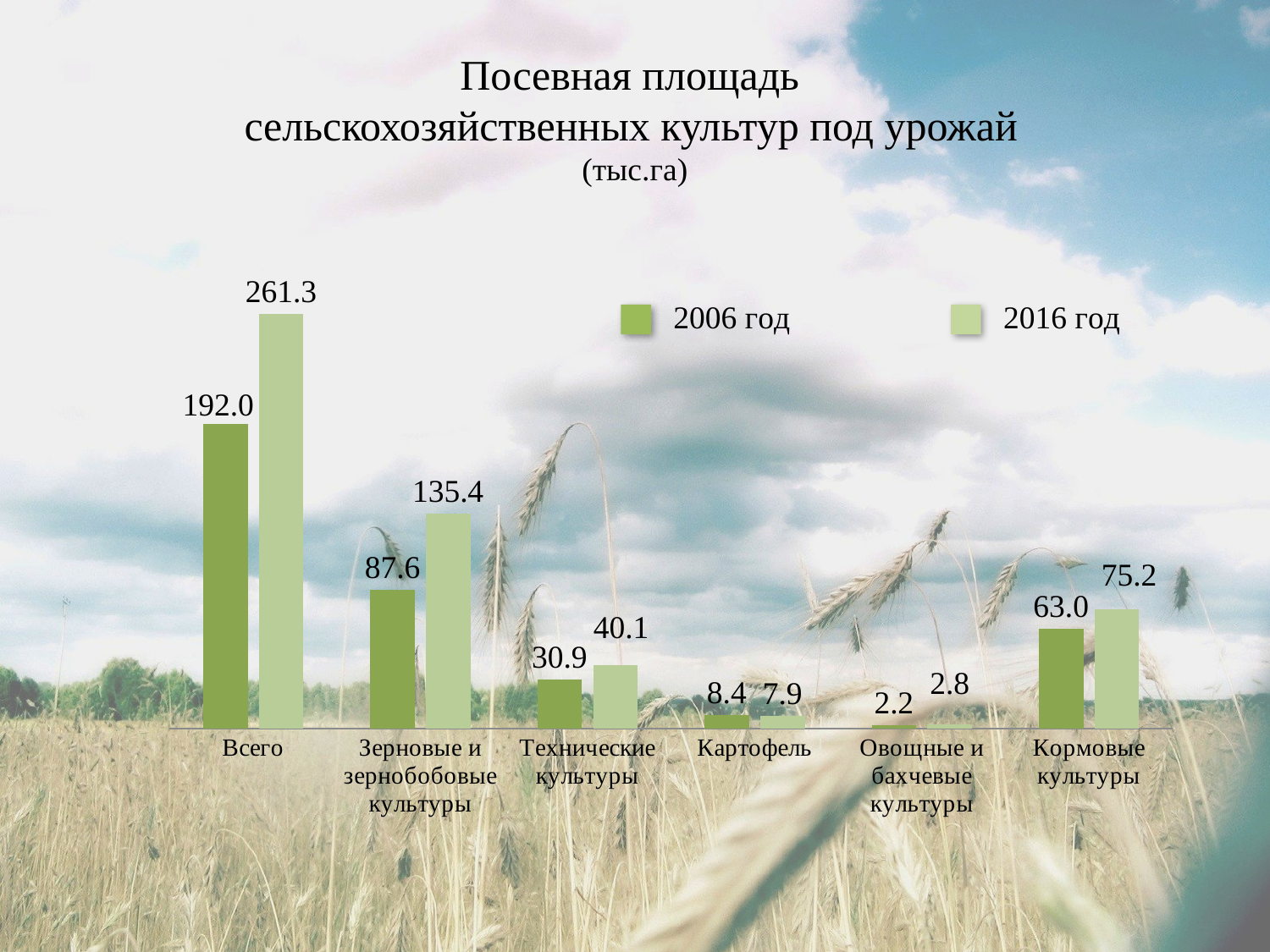
Excluding Всего, which category has the highest value in the 2016 год series? Зерновые и зернобобовые культуры How many categories are shown on the x axis? 6 What type of chart is shown on the slide? bar chart Which is larger for Картофель: the 2006 год value or the 2016 год value? 2006 год What is the value for Зерновые и зернобобовые культуры in 2006 год? 87.6 How many series does the legend list? 2 What is the value for Всего in 2016 год? 261.3 Which category has the lowest value in the 2006 год series? Овощные и бахчевые культуры What is the value for Кормовые культуры in 2006 год? 63.0 What is the difference between the 2016 год and 2006 год values for Всего? 69.3 What unit is given in the chart title? тыс.га What is the value for Картофель in 2016 год? 7.9